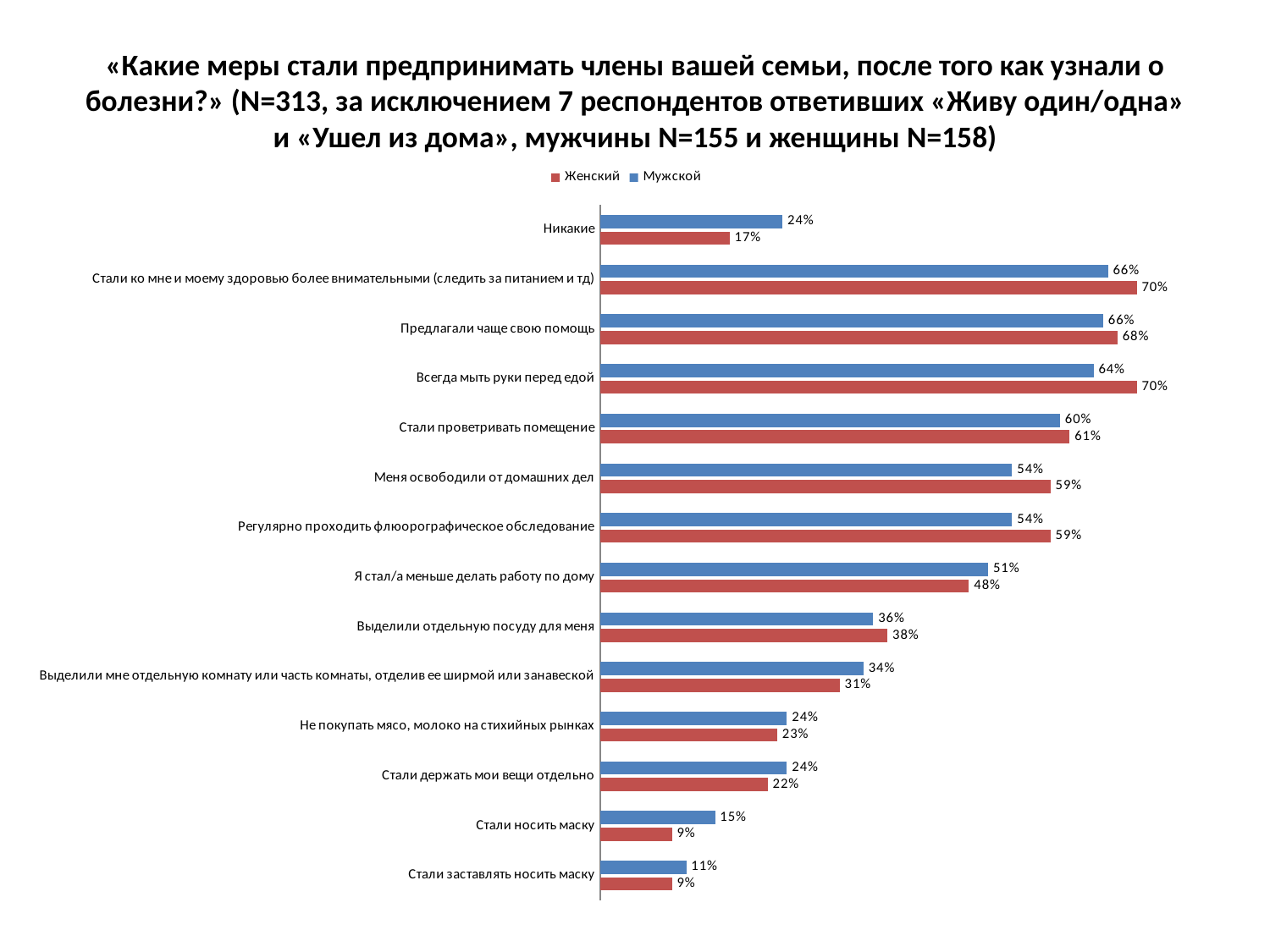
What is the value for Женский for «Всегда мыть руки перед едой»? 70% What is the difference between the Мужской and Женский values for «Никакие»? 7% What is the difference between the Женский and Мужской values for «Всегда мыть руки перед едой»? 6% What is the value for Женский for «Стали носить маску»? 9% Which category has the lowest value for Мужской? Стали заставлять носить маску What type of chart is shown on the slide? bar chart What is the value for Мужской for «Выделили отдельную посуду для меня»? 36% Which series is shown in red? Женский How many categories are shown on the chart? 14 How many series does the legend list? 2 What is the value for Мужской for «Никакие»? 24% For «Я стал/а меньше делать работу по дому», which is larger: the Мужской value or the Женский value? Мужской